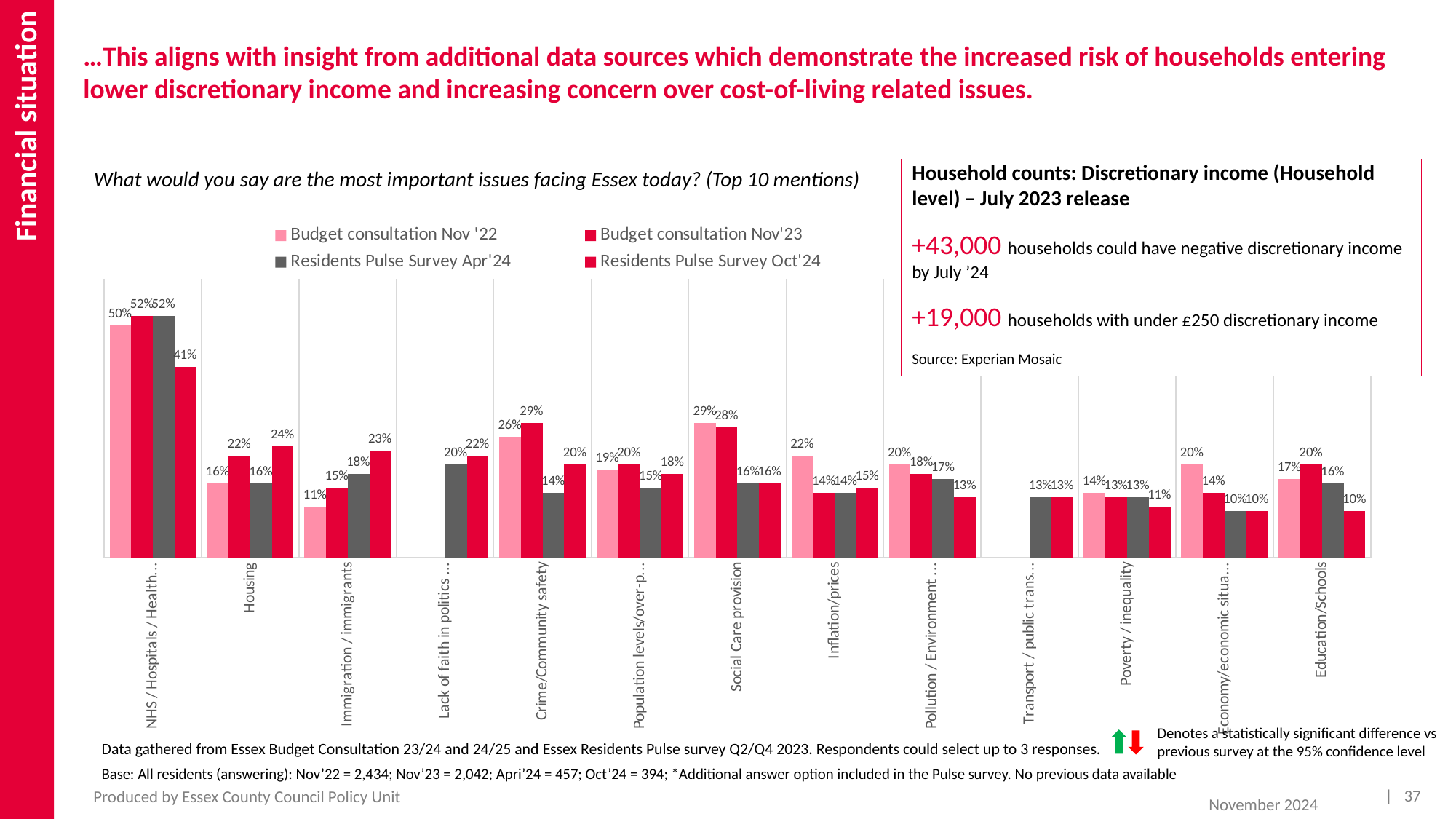
For Pollution / Environment, do the values rise or fall across the four surveys from Nov '22 to Oct'24? Fall For Economy/economic situation, what is the difference between the Budget consultation Nov '22 value and the Residents Pulse Survey Oct'24 value? 10 percentage points Which category has the highest value in the Budget consultation Nov'23 series? NHS / Hospitals / Health Which category has the lowest value in the Budget consultation Nov '22 series? Immigration / immigrants For Immigration / immigrants, do the values rise or fall across the four surveys from Nov '22 to Oct'24? Rise For NHS / Hospitals / Health, what is the difference between the Budget consultation Nov'23 value and the Residents Pulse Survey Oct'24 value? 11 percentage points What is the value for Lack of faith in politics in the Residents Pulse Survey Oct'24 series? 22% In the Budget consultation Nov '22 series, which is larger: Crime/Community safety or Inflation/prices? Crime/Community safety How many series does the legend list? 4 What is the value for Immigration / immigrants in the Residents Pulse Survey Apr'24 series? 18% What is the value for Housing in the Residents Pulse Survey Oct'24 series? 24% What kind of chart is shown on the slide? Bar chart